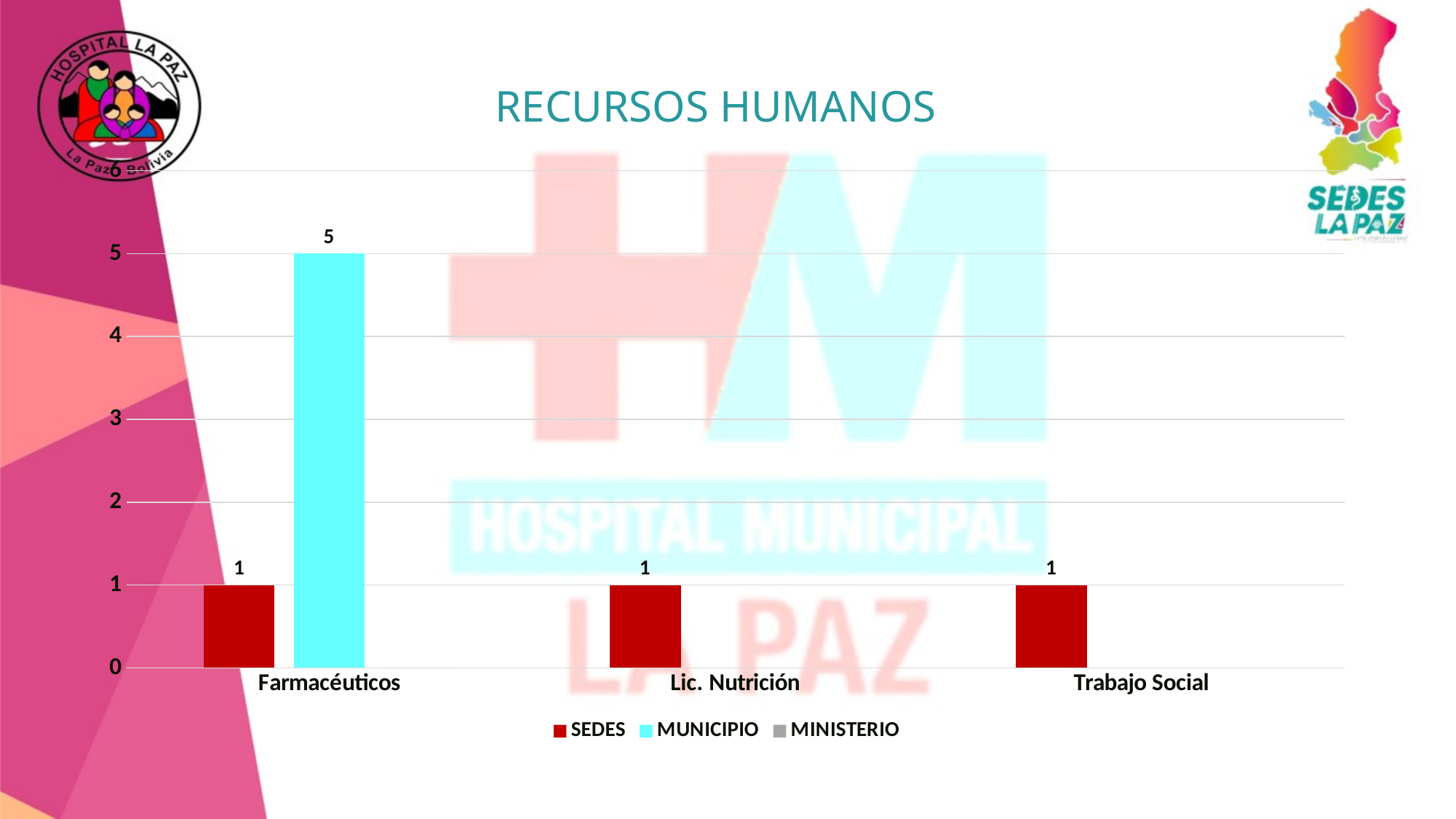
Is the MUNICIPIO value for Farmacéuticos greater or less than 3? greater What is the title of the chart? RECURSOS HUMANOS For Farmacéuticos, which series has the larger value, SEDES or MUNICIPIO? MUNICIPIO How many series does the legend list? 3 What is the SEDES value for Farmacéuticos? 1 What is the difference between the MUNICIPIO and SEDES values for Farmacéuticos? 4 What is the SEDES value for Lic. Nutrición? 1 How many categories are shown on the x axis? 3 What is the SEDES value for Trabajo Social? 1 Which category has the highest bar on the chart? Farmacéuticos What is the MUNICIPIO value for Farmacéuticos? 5 What kind of chart is shown on the slide? bar chart